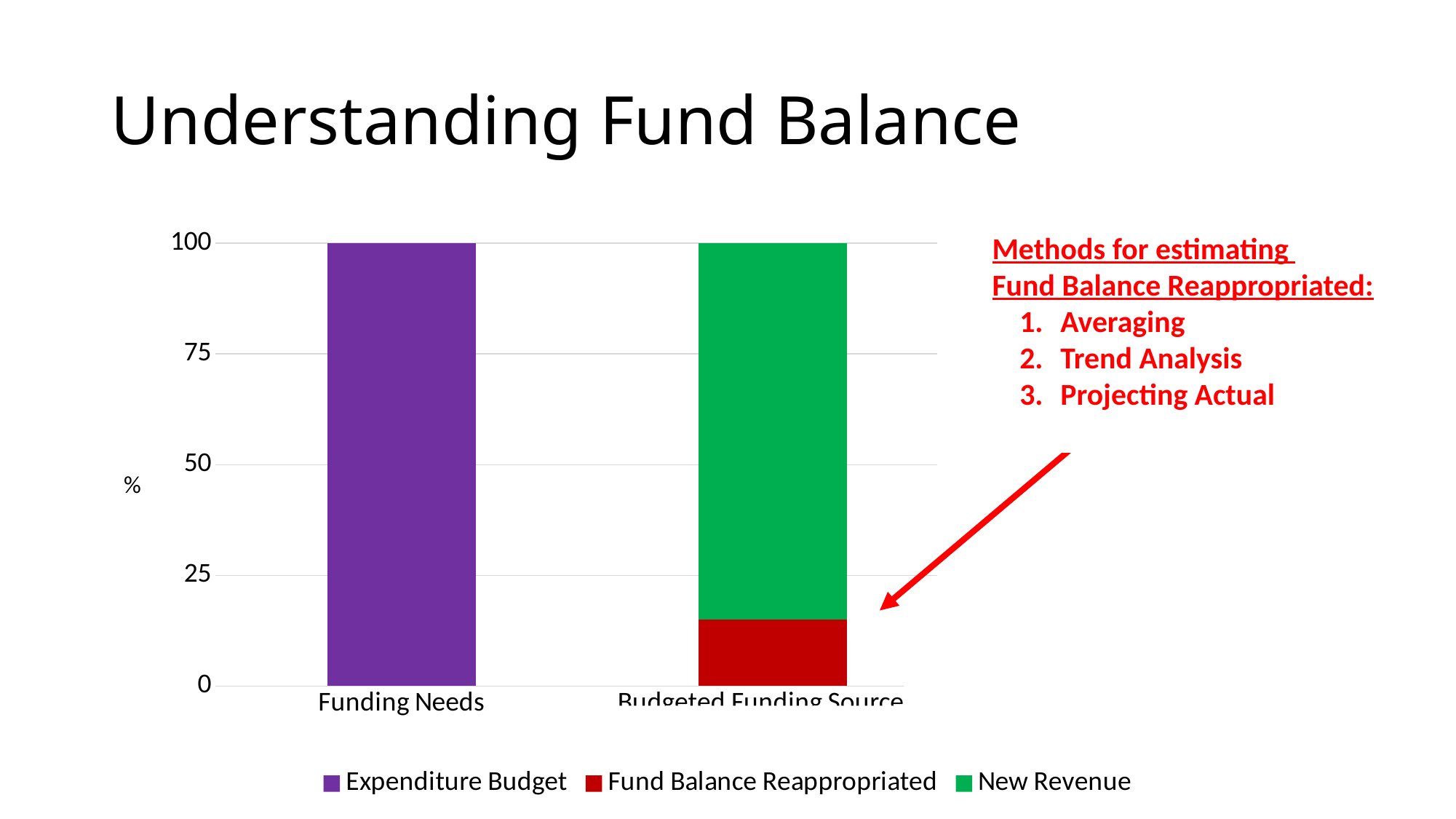
What is the value of the Expenditure Budget bar for Funding Needs? 100 Is the Fund Balance Reappropriated portion of the Budgeted Funding Source bar greater or less than 25? less In the Budgeted Funding Source bar, which is larger: the New Revenue portion or the Fund Balance Reappropriated portion? New Revenue How many series does the chart legend list? 3 What is the highest value shown on the vertical axis of the chart? 100 Which series is shown in purple in the chart? Expenditure Budget Is the New Revenue portion of the Budgeted Funding Source bar greater or less than 75? greater Which category's bar is made up of the Fund Balance Reappropriated and New Revenue series? Budgeted Funding Source What kind of chart is shown on the slide? Stacked bar chart What is the total height of the stacked bar for Budgeted Funding Source? 100 What label is shown on the vertical axis of the chart? % How many categories are shown on the x axis of the chart? 2